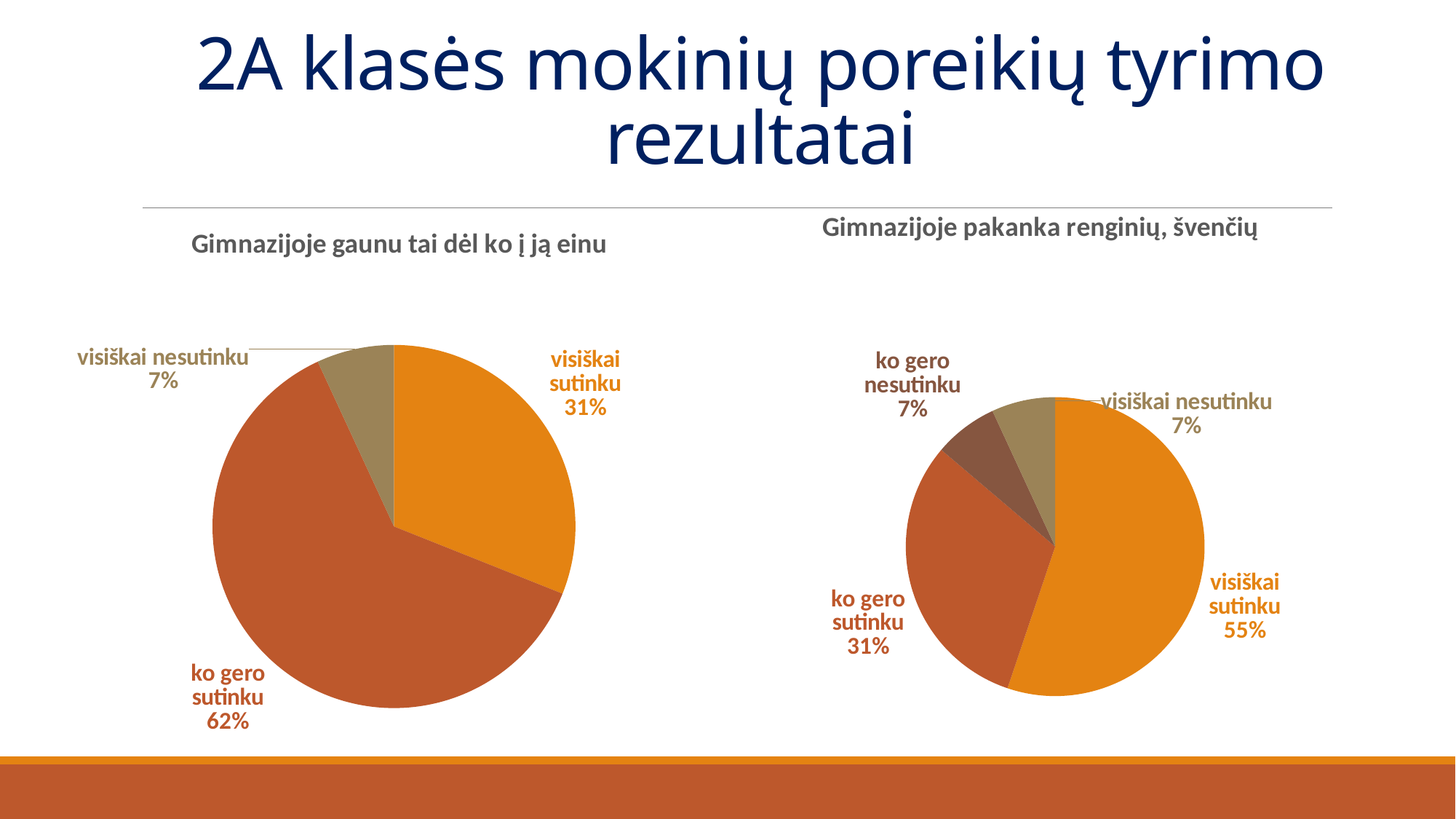
In the chart titled "Gimnazijoje gaunu tai dėl ko į ją einu", how many slices does the pie have? 3 In the chart titled "Gimnazijoje gaunu tai dėl ko į ją einu", what share is labelled for "ko gero sutinku"? 62% In the chart titled "Gimnazijoje gaunu tai dėl ko į ją einu", what share is labelled for "visiškai sutinku"? 31% In the chart titled "Gimnazijoje pakanka renginių, švenčių", which category has the largest slice? visiškai sutinku In the chart titled "Gimnazijoje gaunu tai dėl ko į ją einu", which category has the smallest slice? visiškai nesutinku What type of chart is the chart titled "Gimnazijoje pakanka renginių, švenčių"? Pie chart In the chart titled "Gimnazijoje pakanka renginių, švenčių", which is larger: "visiškai sutinku" or "ko gero sutinku"? visiškai sutinku In the chart titled "Gimnazijoje gaunu tai dėl ko į ją einu", which category has the largest slice? ko gero sutinku In the chart titled "Gimnazijoje gaunu tai dėl ko į ją einu", what is the difference in percentage points between "ko gero sutinku" and "visiškai sutinku"? 31 In the chart titled "Gimnazijoje pakanka renginių, švenčių", what share is labelled for "ko gero sutinku"? 31% In the chart titled "Gimnazijoje pakanka renginių, švenčių", how many slices does the pie have? 4 In the chart titled "Gimnazijoje pakanka renginių, švenčių", what share is labelled for "visiškai sutinku"? 55%